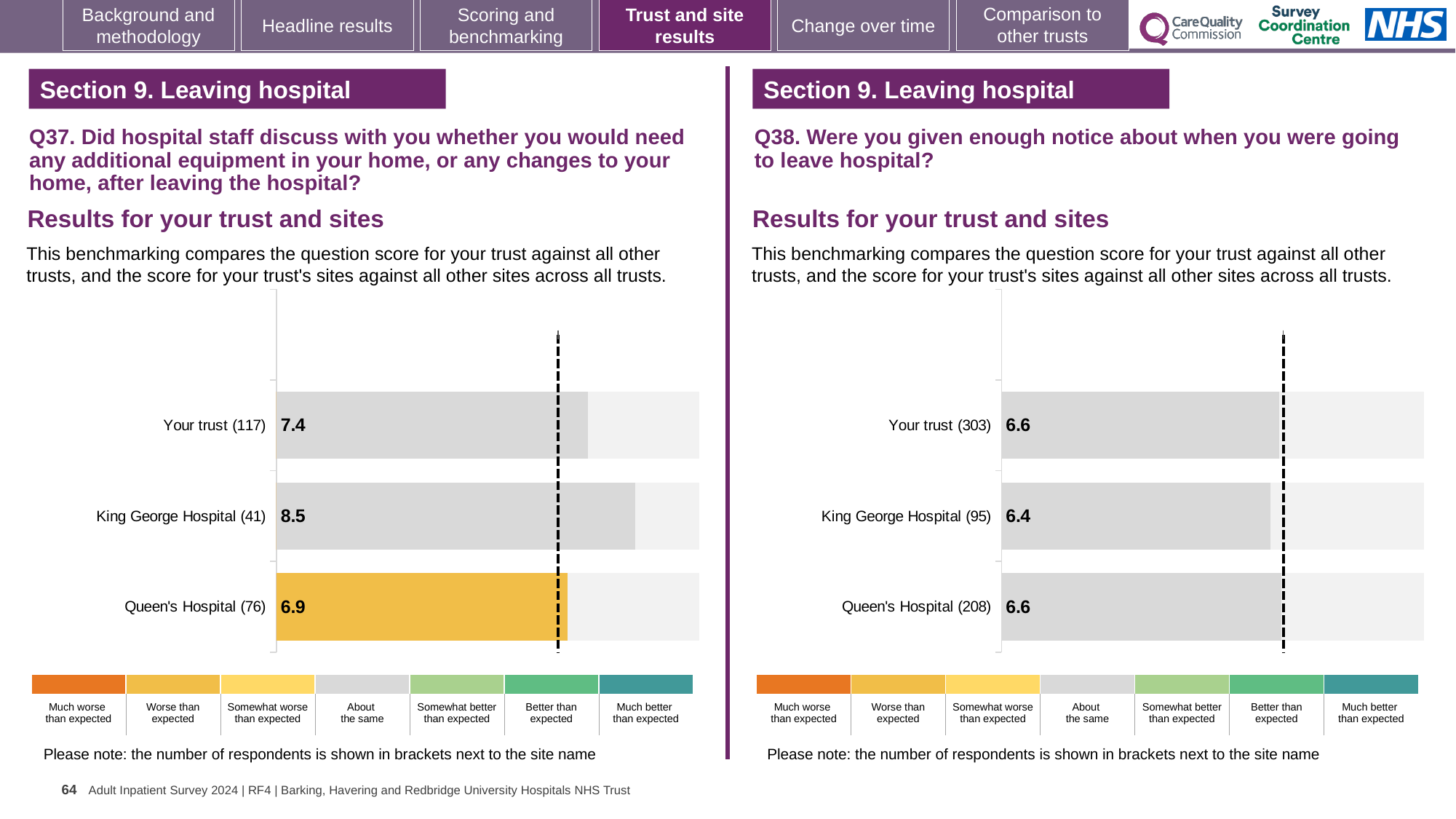
In the Q37 chart on the left, what is the score for King George Hospital? 8.5 In the Q38 chart on the right, what is the score for King George Hospital? 6.4 In the Q37 chart on the left, what is the difference between the scores for King George Hospital and Queen's Hospital? 1.6 In the Q38 chart on the right, what is the difference between the scores for Your trust and King George Hospital? 0.2 In the Q37 chart on the left, what is the score for Queen's Hospital? 6.9 How many bars are shown in the Q38 chart on the right? 3 In the Q37 chart on the left, which site or trust has the highest score? King George Hospital In the Q38 chart on the right, what is the score for Your trust? 6.6 In the Q37 chart on the left, which has the larger score, Your trust or King George Hospital? King George Hospital In the Q37 chart on the left, how many respondents are shown in brackets for Queen's Hospital? 76 In the Q37 chart on the left, which site or trust has the lowest score? Queen's Hospital In the Q38 chart on the right, which site or trust has the lowest score? King George Hospital